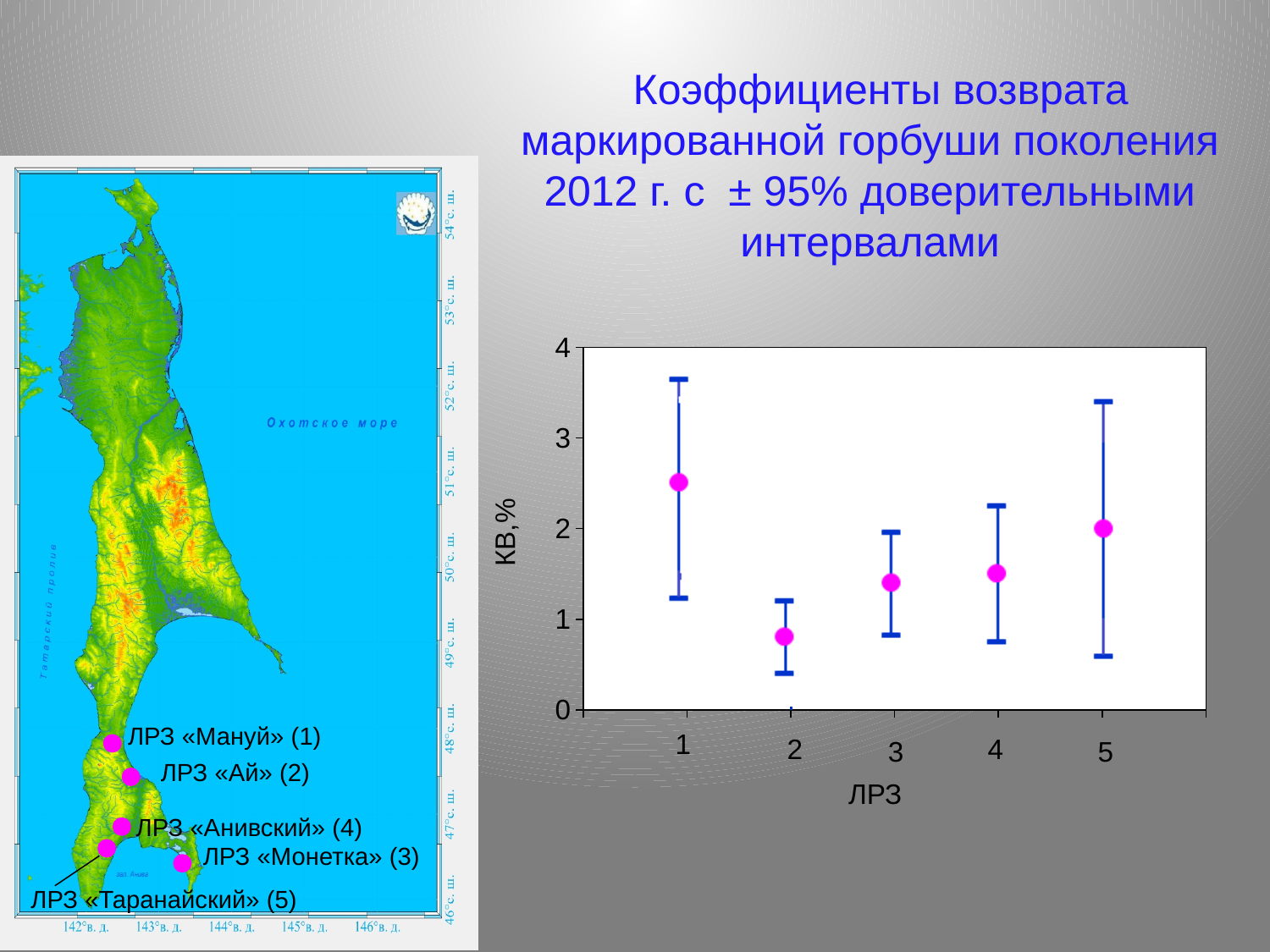
Is the value for ЛРЗ 1 greater or less than 2? greater Which ЛРЗ has the highest return coefficient (КВ,%) on the chart? 1 Which has a larger return coefficient, ЛРЗ 5 or ЛРЗ 2? ЛРЗ 5 How many ЛРЗ points are plotted on the chart? 5 Is the value for ЛРЗ 2 greater or less than 1? less What is the label of the horizontal axis of the chart? ЛРЗ Which has a larger return coefficient, ЛРЗ 1 or ЛРЗ 2? ЛРЗ 1 Which ЛРЗ has the lowest return coefficient (КВ,%) on the chart? 2 What kind of chart is shown on the right of the slide? Scatter (point) chart with error bars Is the value for ЛРЗ 3 greater or less than 1? greater What is the label of the vertical axis of the chart? КВ,%